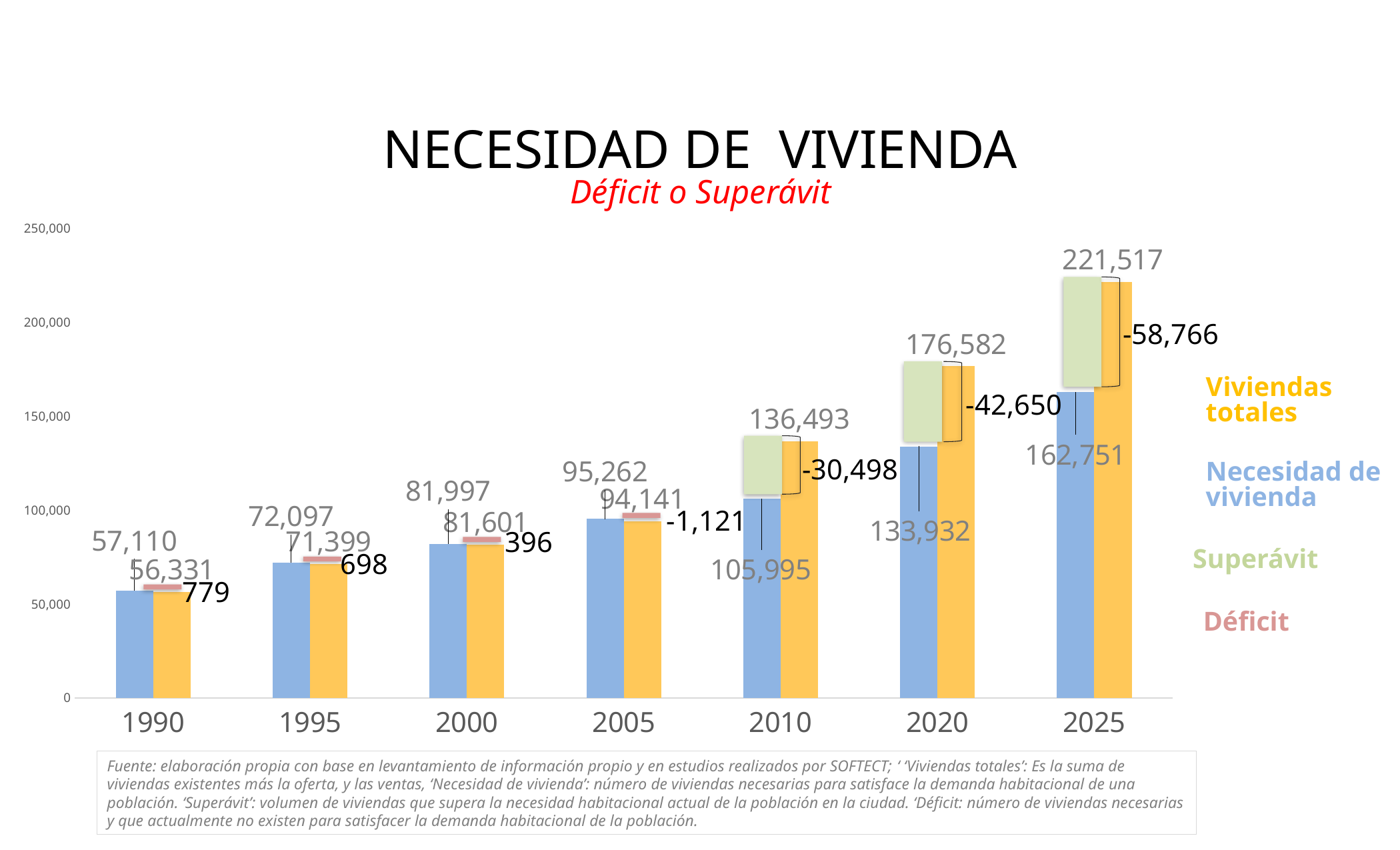
Which year has the lowest value for Necesidad de vivienda? 1990 What value is labelled next to the 2025 bars for the gap between Viviendas totales and Necesidad de vivienda? -58,766 Which year has the highest value for Viviendas totales? 2025 How many years are shown on the x axis? 7 What is the value of Viviendas totales for 2025? 221,517 What is the value of Necesidad de vivienda for 2010? 105,995 Does Viviendas totales rise or fall from 1990 to 2025? rise What is the Déficit value shown for 1995? 698 In 1990, which is larger: Necesidad de vivienda or Viviendas totales? Necesidad de vivienda Is the value of Viviendas totales for 2010 greater or less than 150,000? less What is the difference between Viviendas totales and Necesidad de vivienda in 2020? 42,650 How many series does the legend list? 4